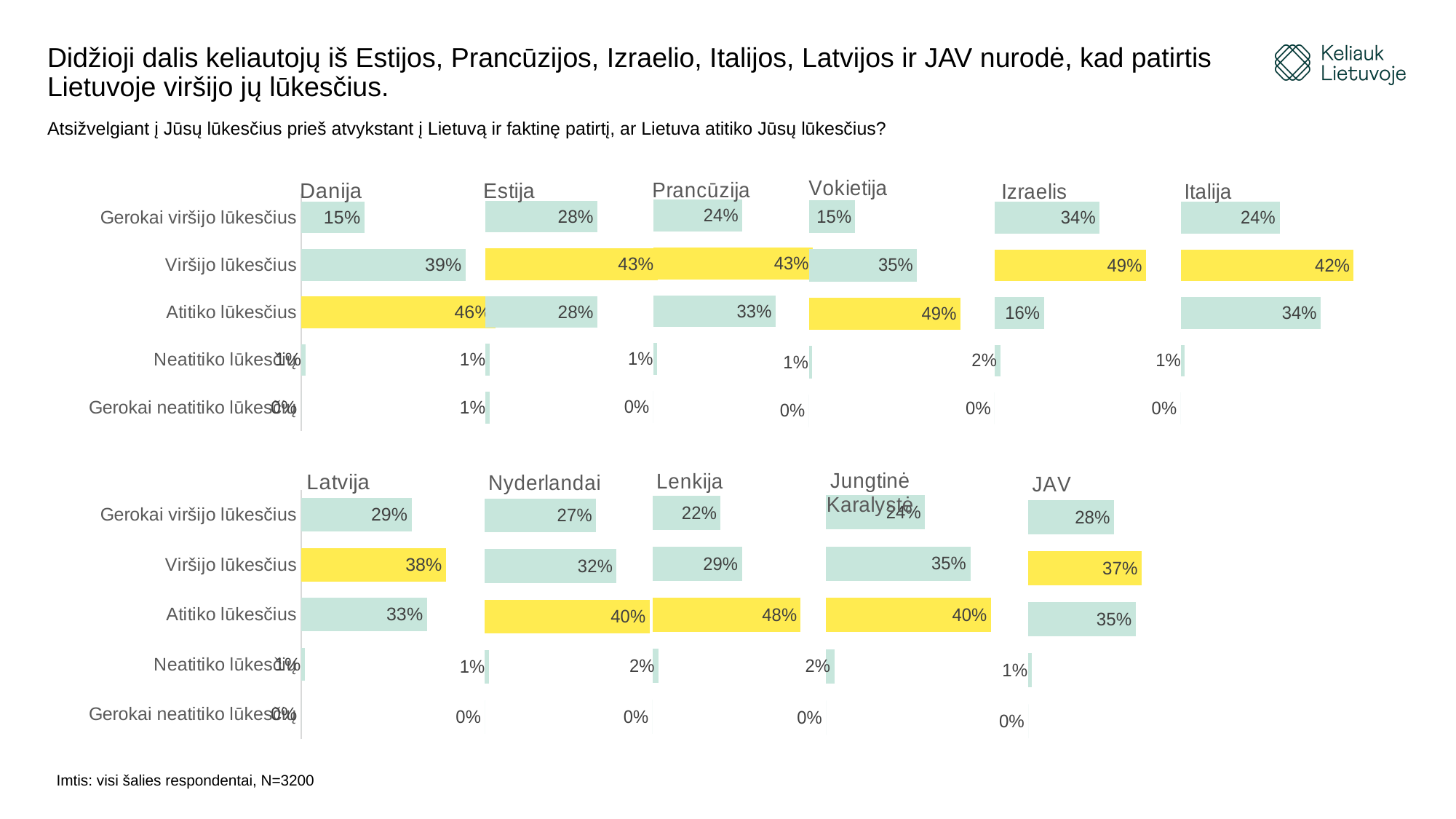
How many country charts are on the slide? 11 In the Estija chart, which category has the highest value? Viršijo lūkesčius In the Lenkija chart, what is the value for "Gerokai viršijo lūkesčius"? 22% In the JAV chart, which is larger: "Viršijo lūkesčius" or "Atitiko lūkesčius"? Viršijo lūkesčius In the Jungtinė Karalystė chart, what is the value for "Neatitiko lūkesčius"? 2% In the Vokietija chart, which category has the highest value? Atitiko lūkesčius How many categories does each country chart show? 5 In the Nyderlandai chart, what is the difference between "Atitiko lūkesčius" and "Gerokai viršijo lūkesčius"? 13% In the Danija chart, what is the value for "Atitiko lūkesčius"? 46% In the Izraelis chart, what is the value for "Viršijo lūkesčius"? 49% What kind of chart is used for each country on the slide? Bar chart In the Izraelis chart, what is the difference between "Viršijo lūkesčius" and "Atitiko lūkesčius"? 33%